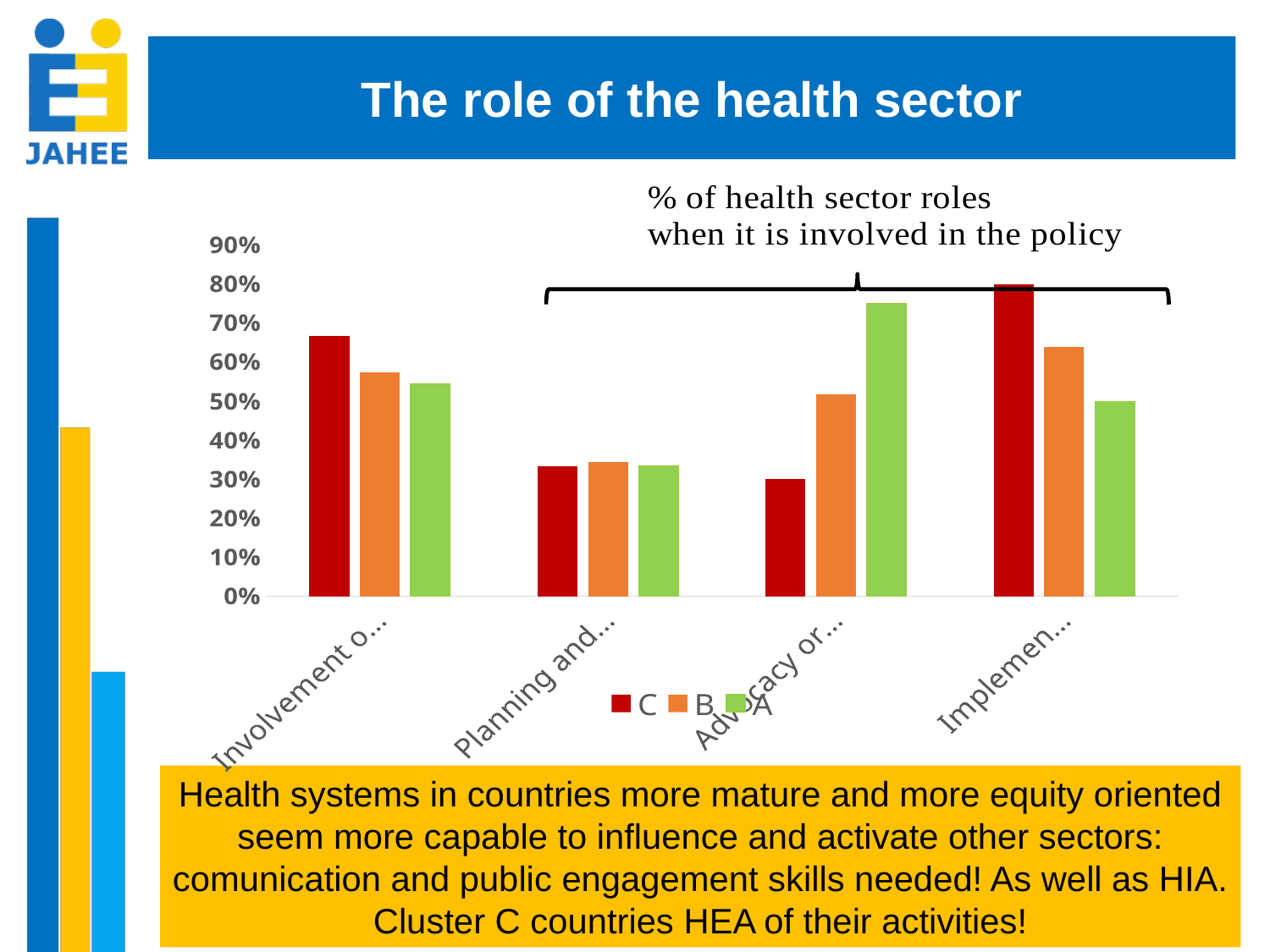
What colour represents series C in the chart legend? red Which series has the lowest value in the fourth category (Implemen...)? A What kind of chart is shown on the slide? bar chart Is the value for series C in the fourth category (Implemen...) greater or less than 70%? greater Is the value for series C in the third category (Advocacy or...) greater or less than 40%? less Which series has the highest value in the fourth category (Implemen...)? C Is the value for series A in the third category (Advocacy or...) greater or less than 70%? greater How many series does the chart legend list? 3 How many categories are shown along the x axis of the chart? 4 Which series has the highest value in the third category (Advocacy or...)? A For series C, which is larger: the value in the first category (Involvement o...) or the value in the second category (Planning and...)? Involvement o...